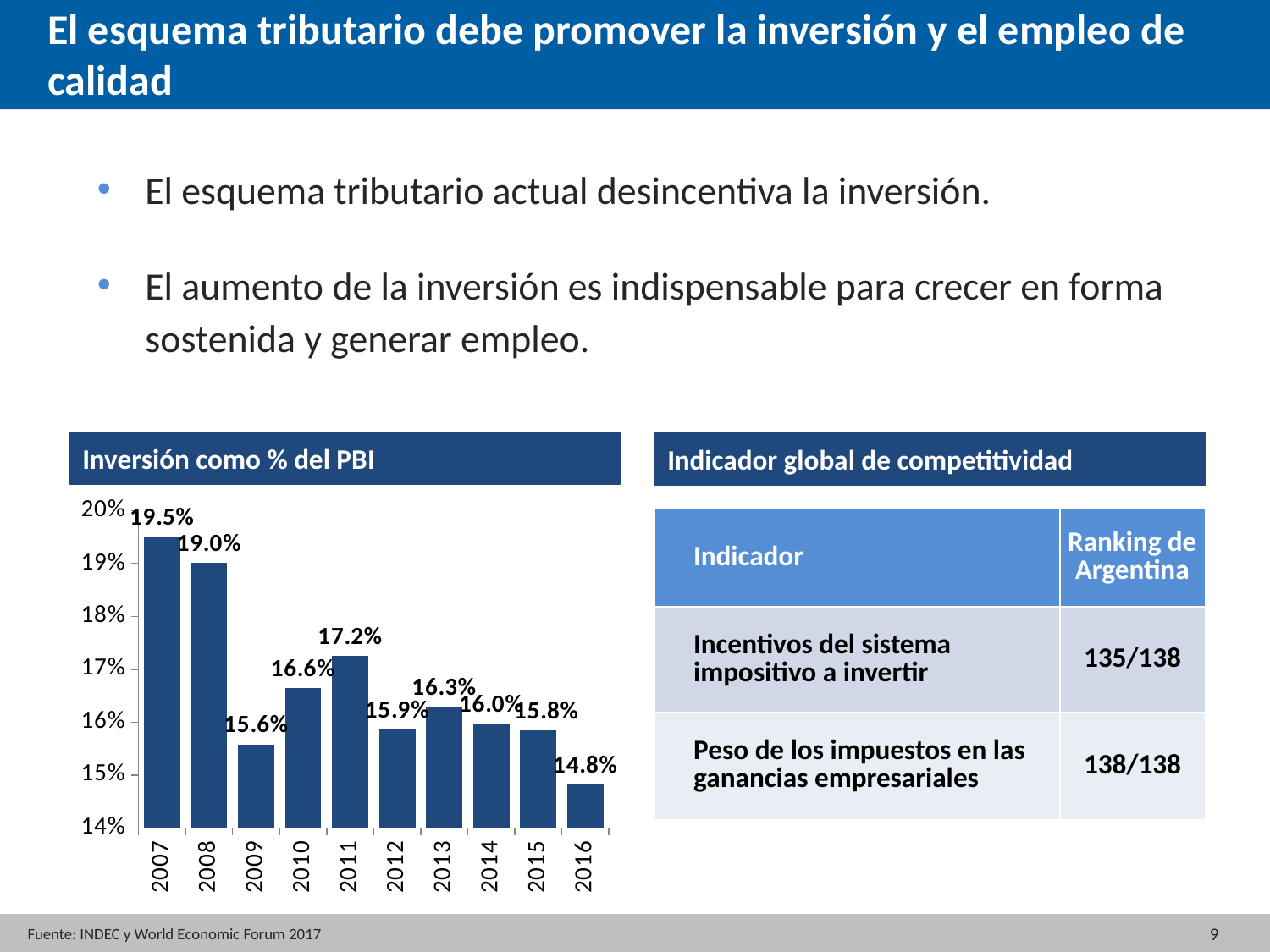
In the 'Inversión como % del PBI' chart, do the values generally rise or fall from 2007 to 2016? Fall Which year has the highest value in the 'Inversión como % del PBI' chart? 2007 What kind of chart is 'Inversión como % del PBI'? Bar chart In the 'Inversión como % del PBI' chart, what is the difference between the 2007 value and the 2016 value? 4.7 percentage points What is the investment as % of GDP for 2007 in the 'Inversión como % del PBI' chart? 19.5% In the 'Inversión como % del PBI' chart, is the value for 2009 greater or less than 16%? less What value does the 'Inversión como % del PBI' chart show for 2011? 17.2% What is the title of the chart on the left of the slide? Inversión como % del PBI Which year has the lowest value in the 'Inversión como % del PBI' chart? 2016 In the 'Inversión como % del PBI' chart, which year has a larger value, 2010 or 2013? 2010 What value does the 'Inversión como % del PBI' chart show for 2016? 14.8% How many years are shown on the x axis of the 'Inversión como % del PBI' chart? 10